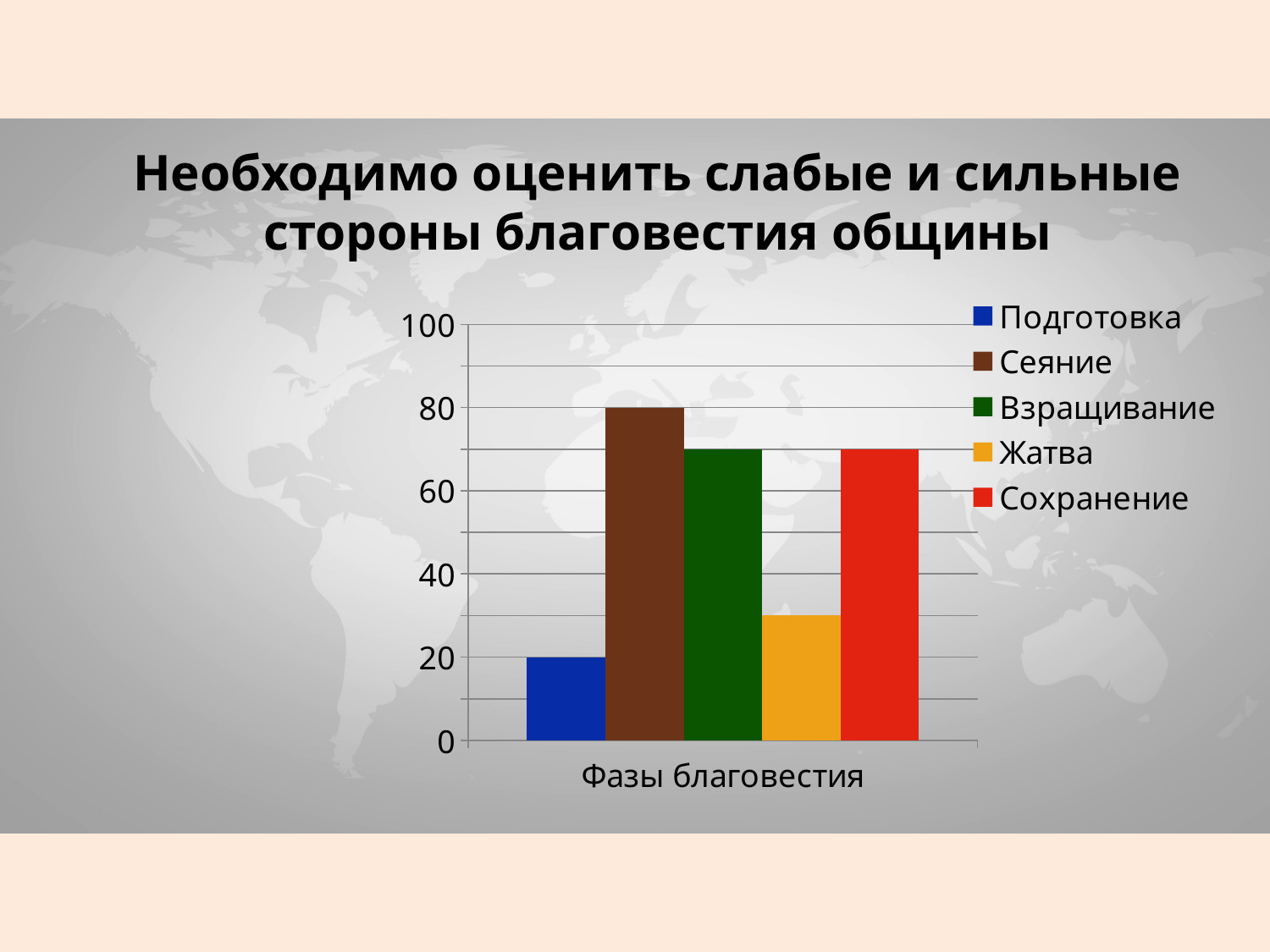
Which is larger, the value for Сеяние or the value for Взращивание? Сеяние What is the difference between the values for Сеяние and Подготовка? 60 How many categories are shown on the x axis? 1 What is the value for Сеяние? 80 Which series has the lowest value? Подготовка What is the value for Подготовка? 20 Is the value for Взращивание greater or less than 60? greater What is the label on the x axis of the chart? Фазы благовестия Which series has the highest value? Сеяние How many series does the legend list? 5 Is the value for Жатва greater or less than 40? less What type of chart is shown on the slide? Bar chart